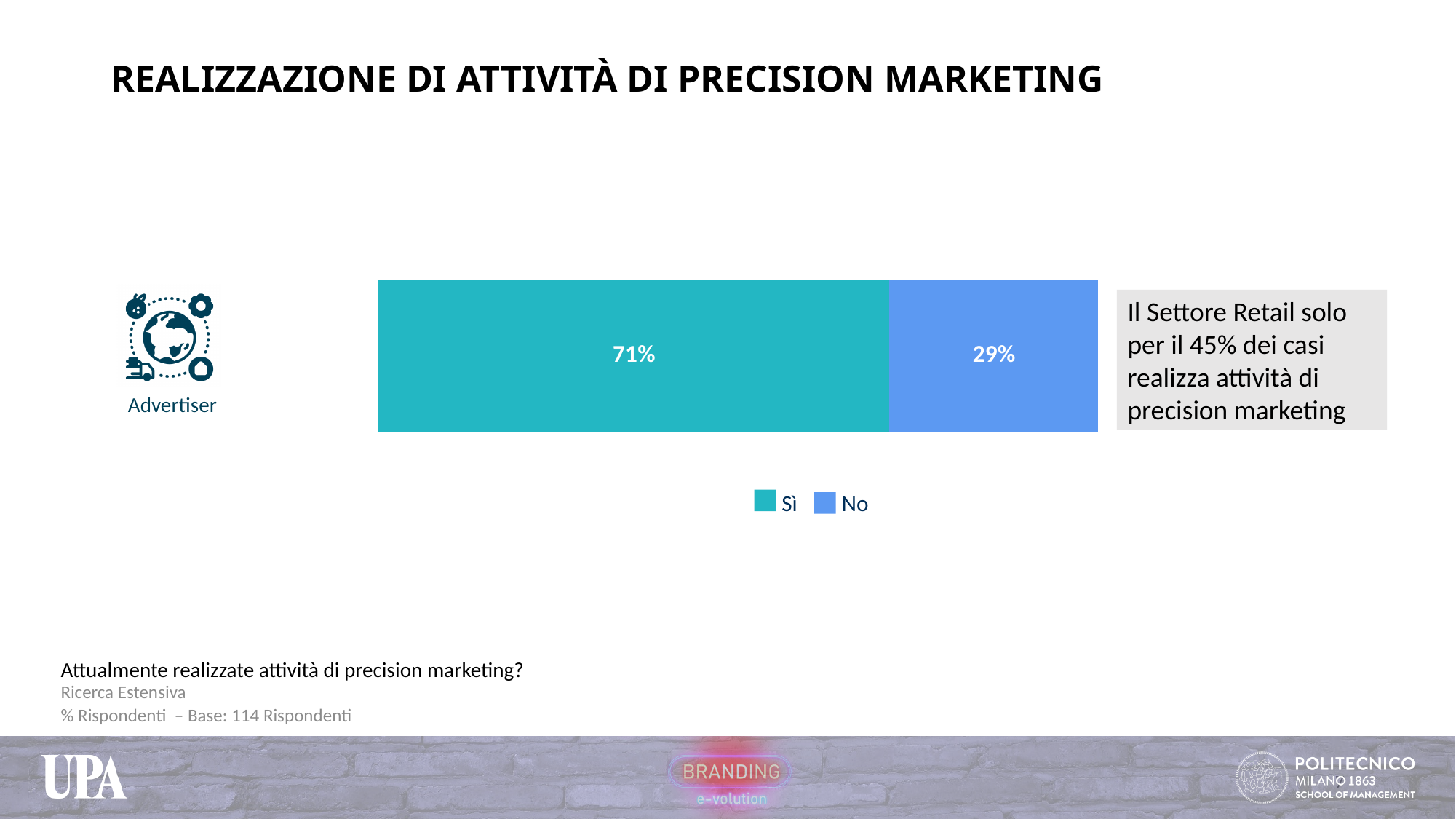
What kind of chart is shown on the slide? Stacked bar chart Which series is the smallest segment in the Advertiser bar? No What is the base number of respondents stated on the slide? 114 Rispondenti What percentage of Advertiser respondents answered "Sì"? 71% Which series is the largest segment in the Advertiser bar? Sì What colour represents "Sì" in the legend? Teal How many categories are plotted in the chart? 1 How many series does the legend list? 2 What is the difference in percentage points between the "Sì" and "No" shares for Advertiser? 42 Which response, "Sì" or "No", has the larger share for Advertiser? Sì What is the total of the two segments in the Advertiser bar? 100% What percentage of Advertiser respondents answered "No"? 29%